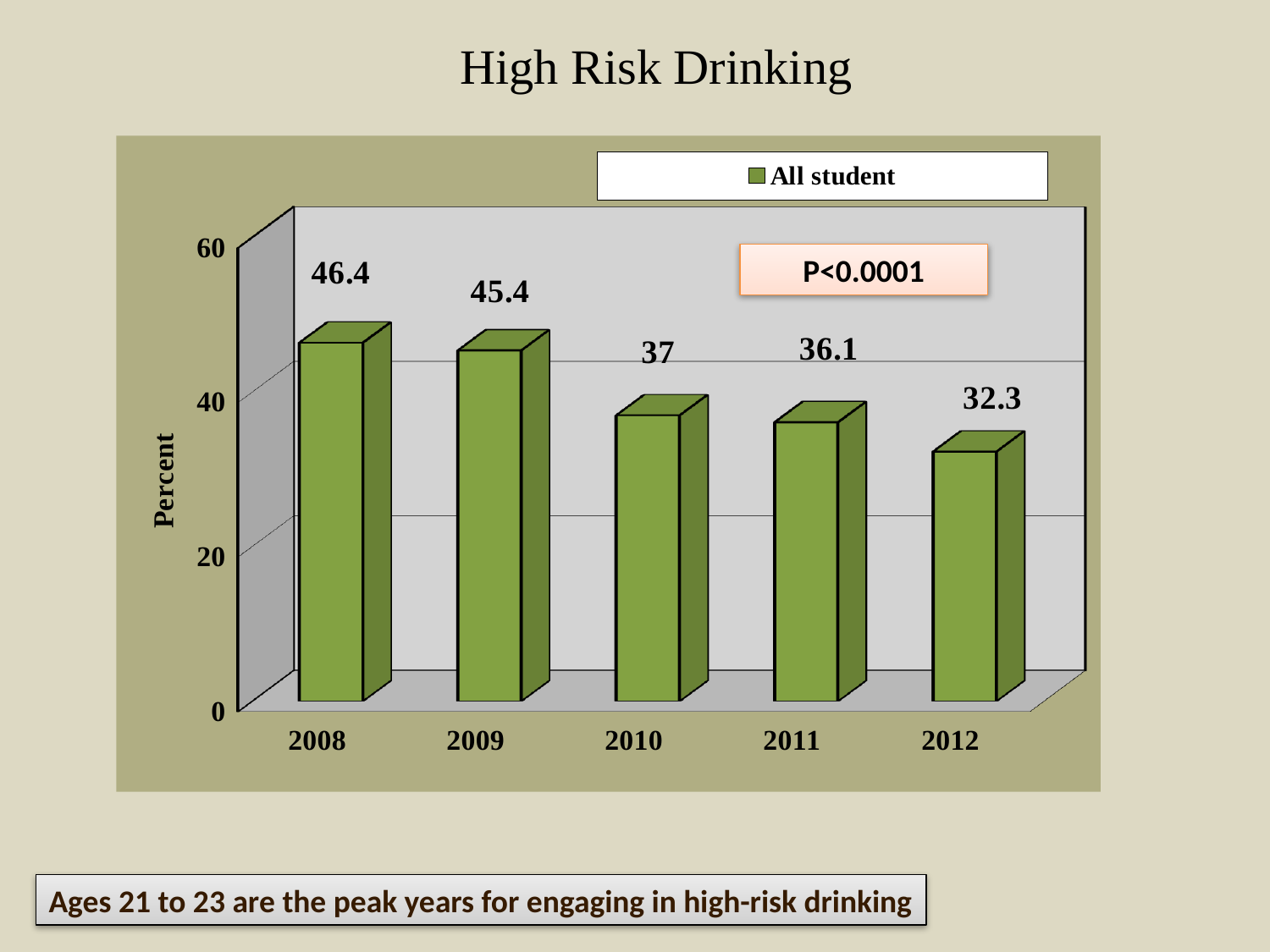
What kind of chart is shown? bar chart What is the difference between the values for 2008 and 2012? 14.1 Is the value for 2011 greater or less than 40? less Which year has the highest value? 2008 What is the value for 2008? 46.4 How many years are shown on the x axis? 5 How many series does the legend list? 1 Which is larger, the value for 2009 or the value for 2011? 2009 What is the value for 2010? 37 Do the values rise or fall from 2008 to 2012? fall What is the value for 2012? 32.3 Which year has the lowest value? 2012